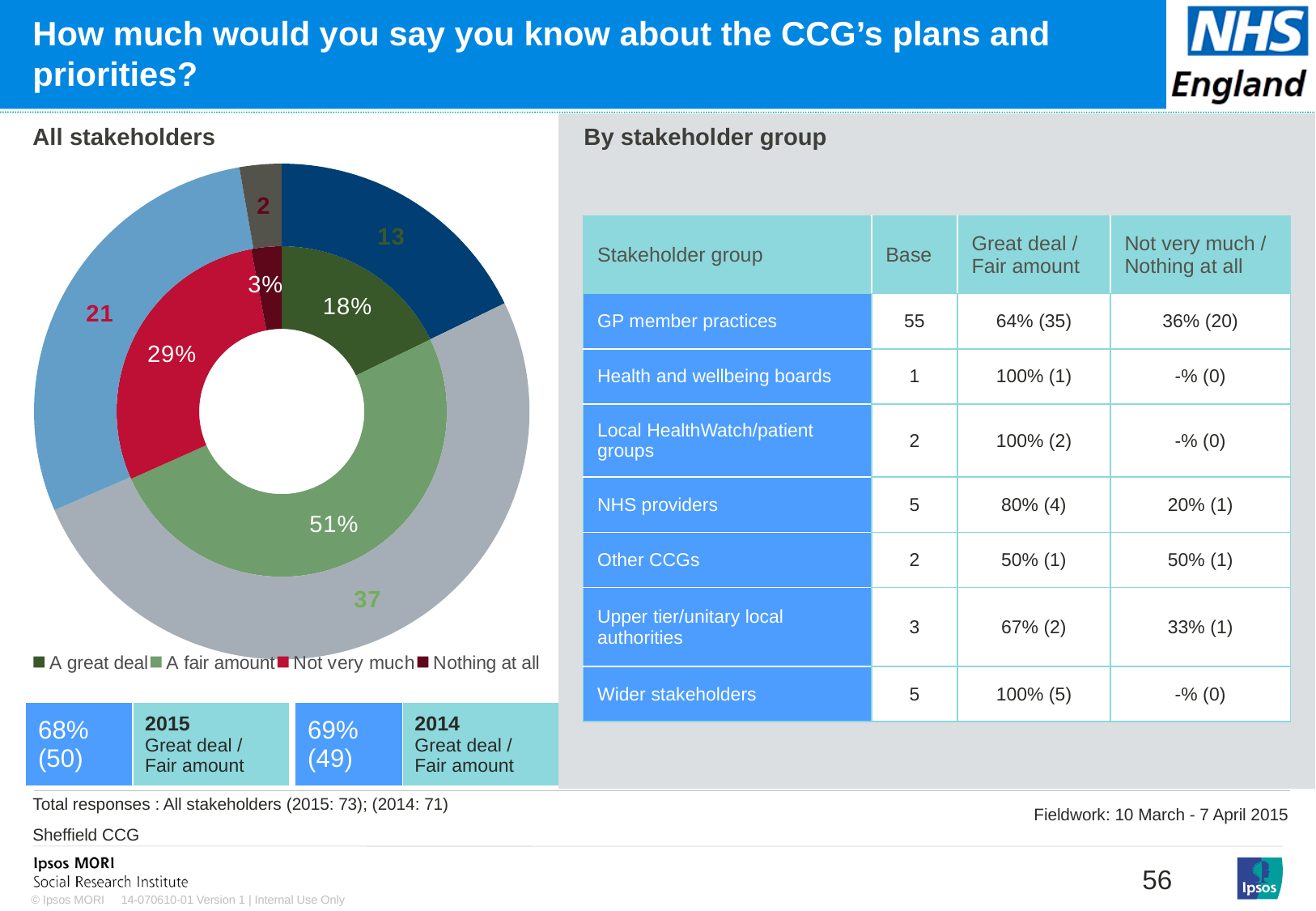
In the 'All stakeholders' chart, what percentage is shown for 'A fair amount'? 51% In the 'All stakeholders' chart, what count is shown on the outer ring for 'Not very much'? 21 In the 'All stakeholders' chart, what is the difference in percentage points between 'A fair amount' and 'Not very much'? 22 In the 'All stakeholders' chart, what percentage is shown for 'Nothing at all'? 3% In the 'All stakeholders' chart, what percentage is shown for 'Not very much'? 29% How many categories does the legend of the 'All stakeholders' chart list? 4 In the 'All stakeholders' chart, what percentage is shown for 'A great deal'? 18% In the 'All stakeholders' chart, what count is shown on the outer ring for 'A fair amount'? 37 In the 'All stakeholders' chart, which response category has the smallest share? Nothing at all What kind of chart is shown under 'All stakeholders'? doughnut chart In the 'All stakeholders' chart, which response category has the largest share? A fair amount In the 'All stakeholders' chart, which is larger: 'A great deal' or 'Not very much'? Not very much